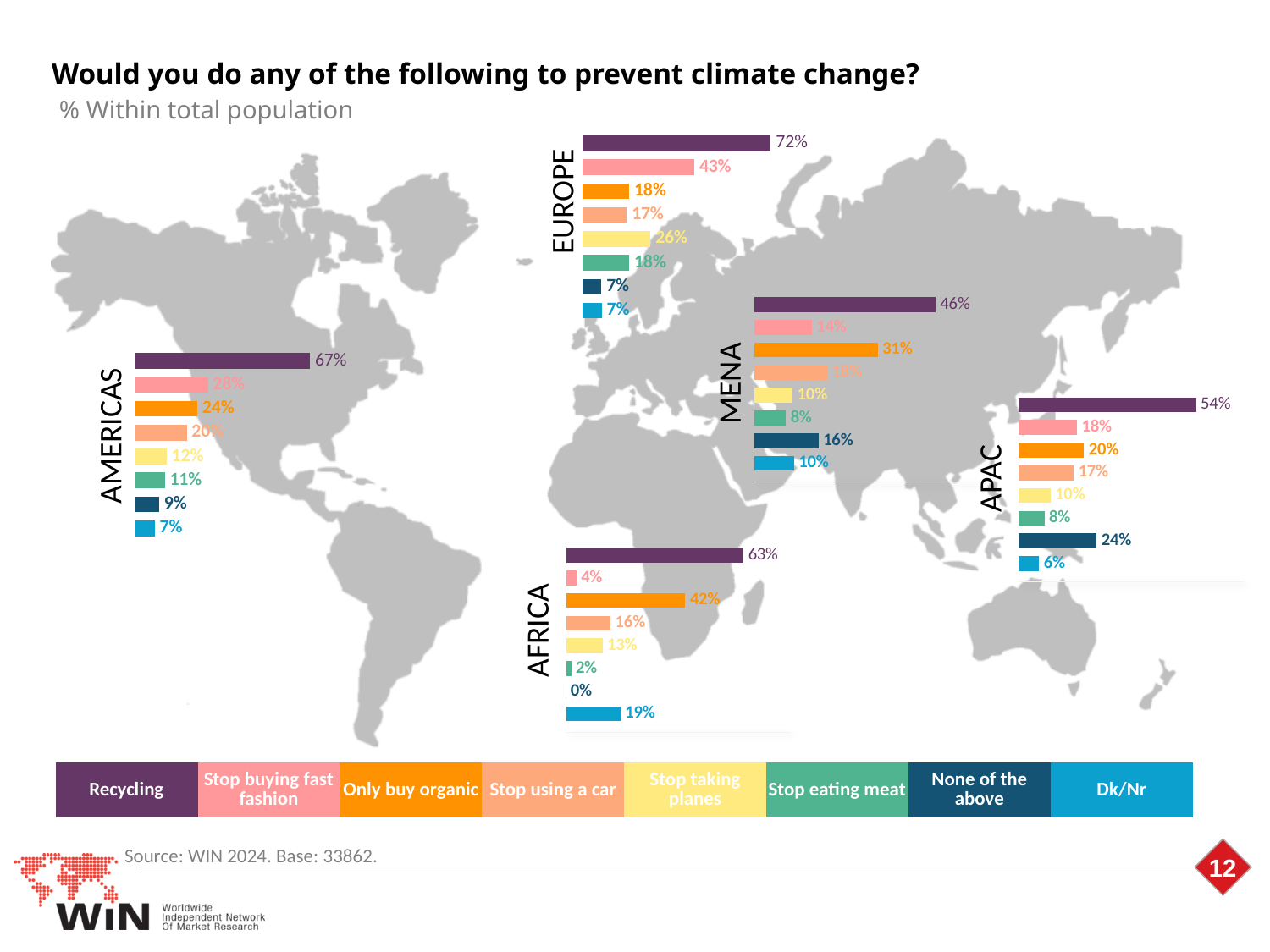
What is the difference between the Recycling percentage in the EUROPE chart and the Recycling percentage in the APAC chart? 18% How many entries does the legend at the bottom of the slide list? 8 In the AFRICA chart, what percentage answered Dk/Nr? 19% In the AFRICA chart, which action has the lowest percentage? None of the above How many actions (bars) are shown in the MENA chart? 8 In the APAC chart, what percentage chose None of the above? 24% What type of chart is used for each region on the slide? Bar chart In the AFRICA chart, what percentage would Only buy organic? 42% Which is larger: Stop buying fast fashion in the EUROPE chart or Stop buying fast fashion in the AFRICA chart? EUROPE In the MENA chart, what percentage would Stop eating meat? 8% In the EUROPE chart, what percentage would do Recycling to prevent climate change? 72% In the AMERICAS chart, which action has the highest percentage? Recycling